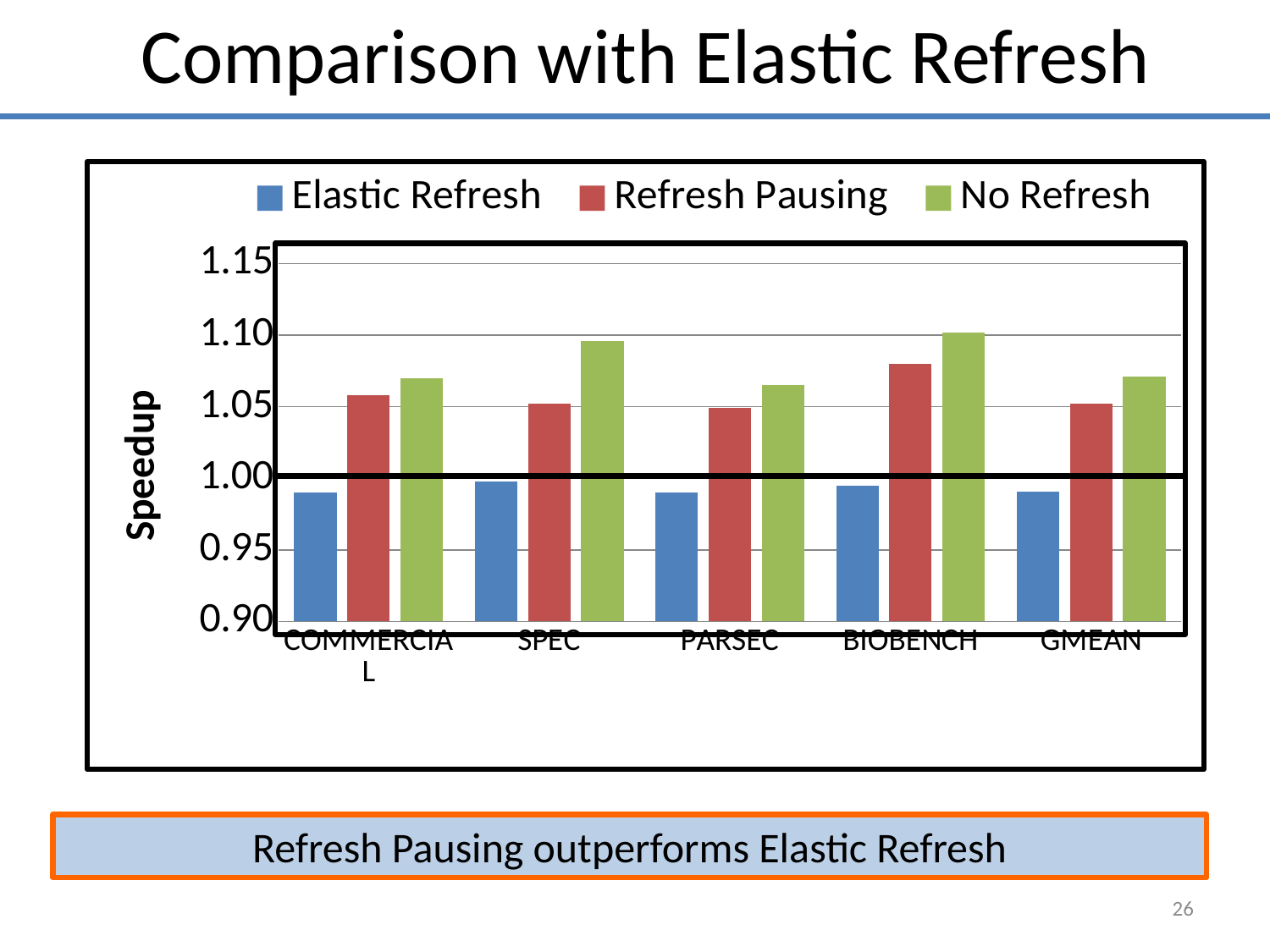
For SPEC, which is larger: Refresh Pausing or No Refresh? No Refresh What is the label of the y axis? Speedup Is the No Refresh value for SPEC greater or less than 1.05? greater How many series does the legend list? 3 For which category is the Refresh Pausing value highest? BIOBENCH How many categories are shown on the x axis? 5 For GMEAN, which is larger: Elastic Refresh or Refresh Pausing? Refresh Pausing What kind of chart is shown on the slide? bar chart Is the Elastic Refresh value for COMMERCIAL greater or less than 1.00? less Which series is shown in green in the legend? No Refresh Is the Refresh Pausing value for BIOBENCH greater or less than 1.05? greater